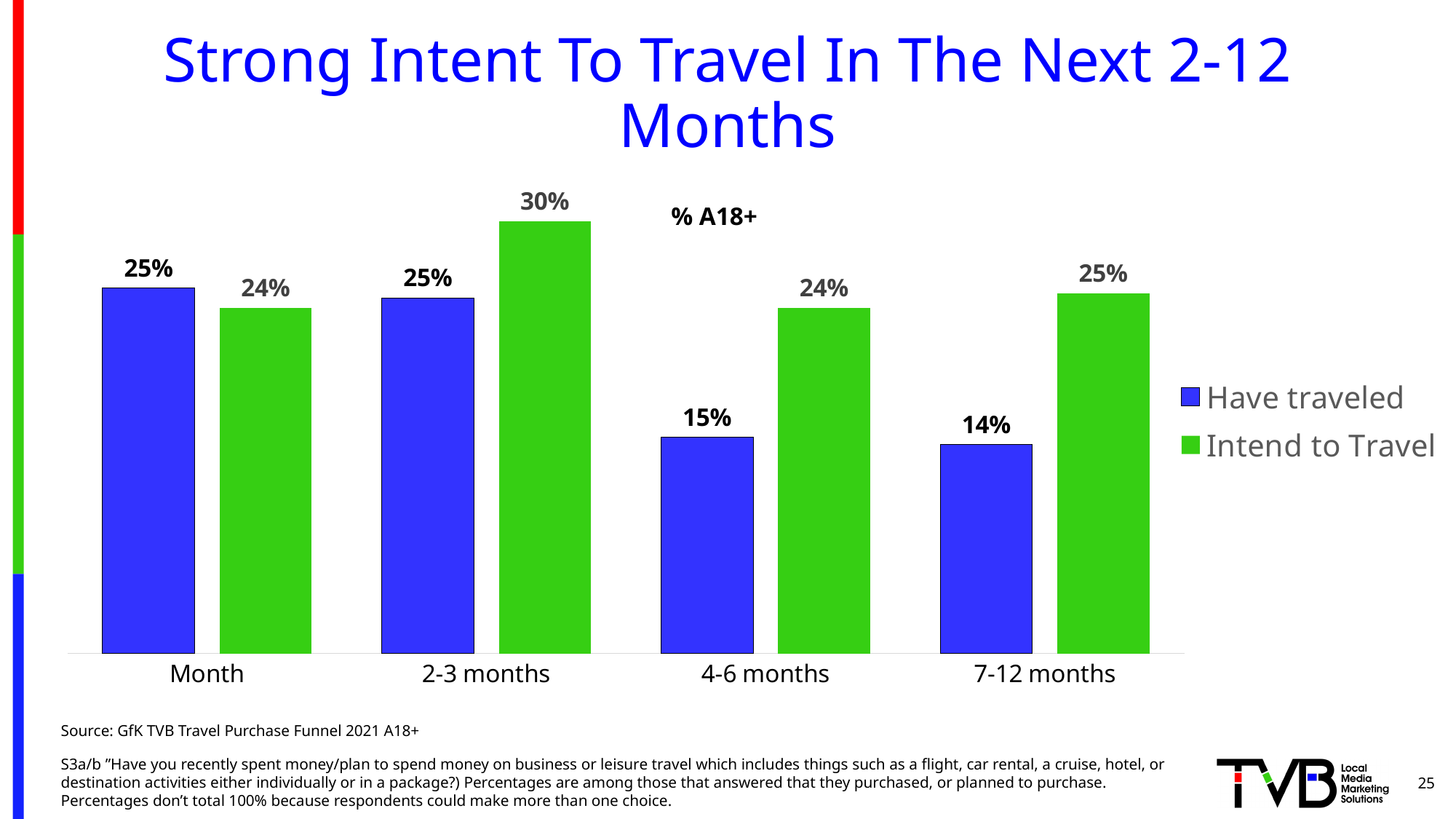
What is the value for Intend to Travel in the 2-3 months category? 30% What colour are the Intend to Travel bars? Green What is the value for Have traveled in the 7-12 months category? 14% In the 4-6 months category, which is larger: Have traveled or Intend to Travel? Intend to Travel What is the value for Have traveled in the 4-6 months category? 15% What is the value for Intend to Travel in the Month category? 24% How many categories are shown on the x axis? 4 What is the difference between Intend to Travel and Have traveled in the 7-12 months category? 11% Which category has the highest Intend to Travel value? 2-3 months Which category has the lowest Have traveled value? 7-12 months What kind of chart is shown on the slide? Bar chart How many series does the legend list? 2